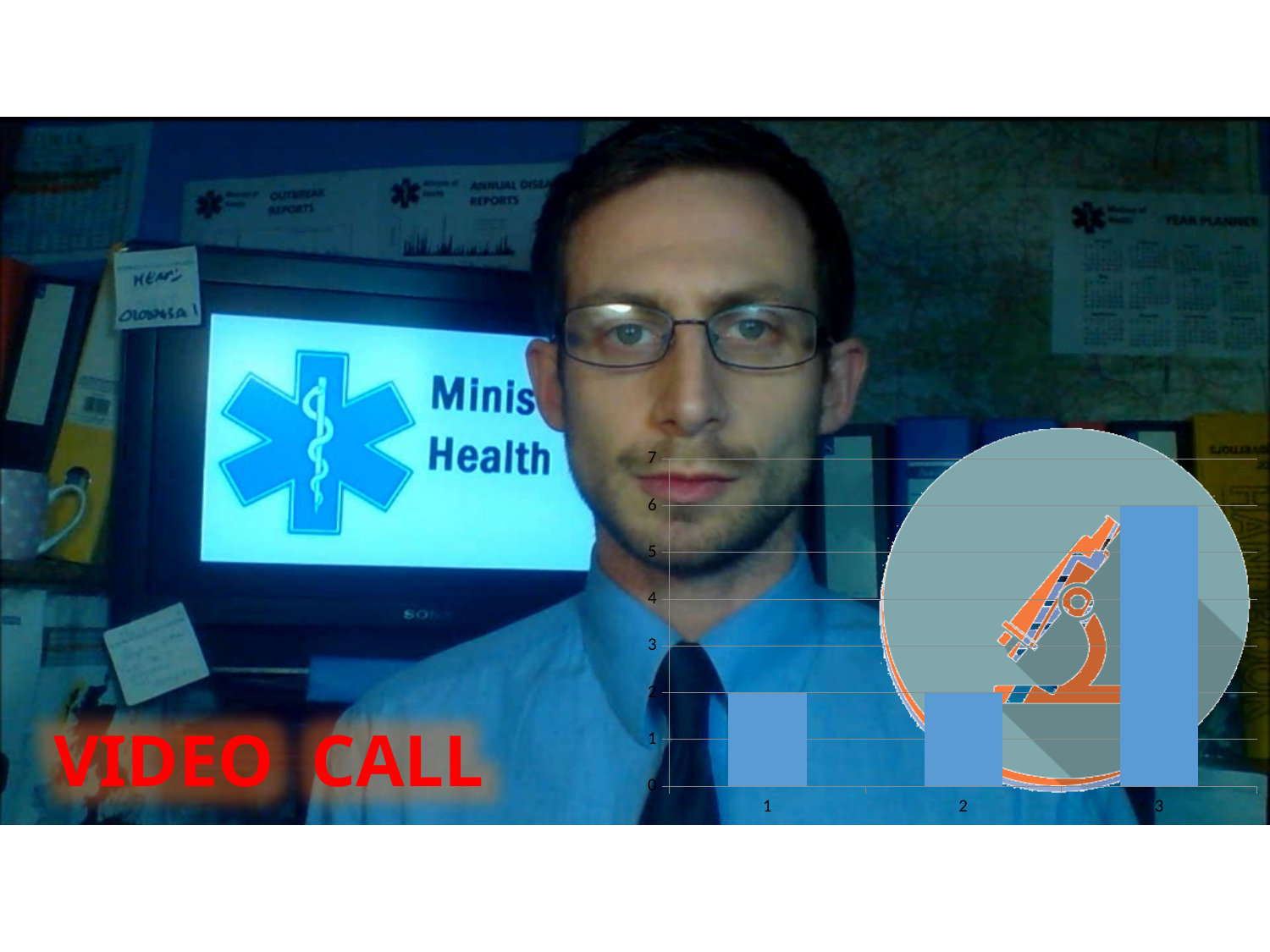
What is the difference between the values for category 3 and category 1? 4 What kind of chart is shown on the slide? bar chart What is the value of the bar for category 3? 6 Is the value for category 3 greater or less than 5? greater Is the value for category 1 greater or less than 3? less How many bars does the chart show? 3 What is the value of the bar for category 1? 2 Is the bar for category 3 higher or lower than the bar for category 2? higher What is the highest value shown on the vertical axis? 7 Which category has the highest bar? 3 Which is larger, the bar for category 3 or the bar for category 1? 3 What is the value of the bar for category 2? 2